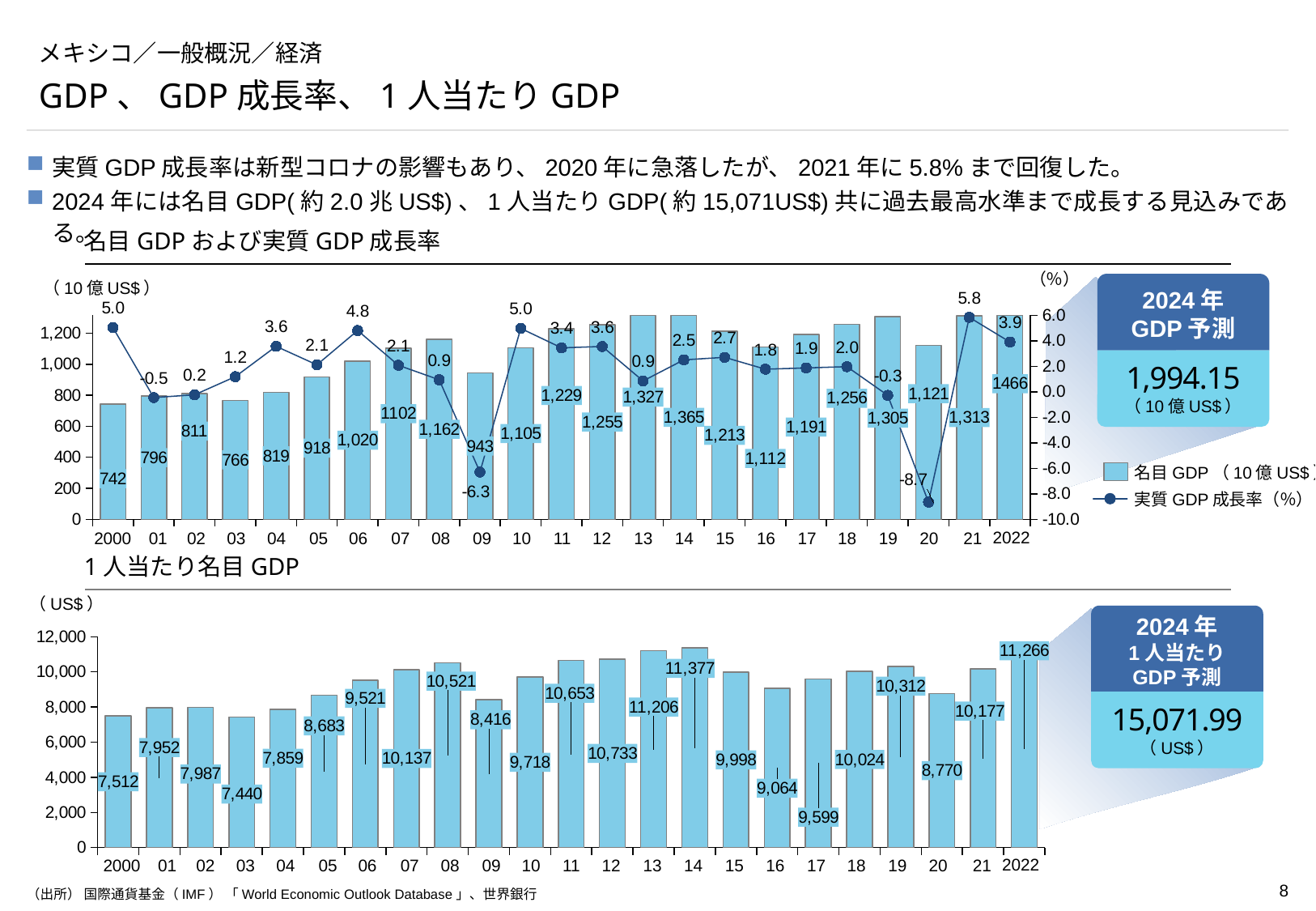
In the top chart (名目GDPおよび実質GDP成長率), which year has the highest nominal GDP bar? 2022 In the bottom chart (1人当たり名目GDP), which year has the highest value? 2014 In the top chart (名目GDPおよび実質GDP成長率), which year has the lowest real GDP growth rate? 2020 What type of chart is the bottom chart (1人当たり名目GDP)? Bar chart In the top chart (名目GDPおよび実質GDP成長率), what is the real GDP growth rate for 2020? -8.7 In the top chart (名目GDPおよび実質GDP成長率), what is the nominal GDP value for 2009? 943 In the bottom chart (1人当たり名目GDP), how many years are plotted on the x axis? 23 In the top chart (名目GDPおよび実質GDP成長率), what is the difference between the nominal GDP of 2022 and 2021? 153 In the top chart (名目GDPおよび実質GDP成長率), how many series does the legend list? 2 In the bottom chart (1人当たり名目GDP), what is the value for 2016? 9,064 In the bottom chart (1人当たり名目GDP), which year has the lowest value? 2003 In the bottom chart (1人当たり名目GDP), which is larger, the value for 2008 or the value for 2009? 2008